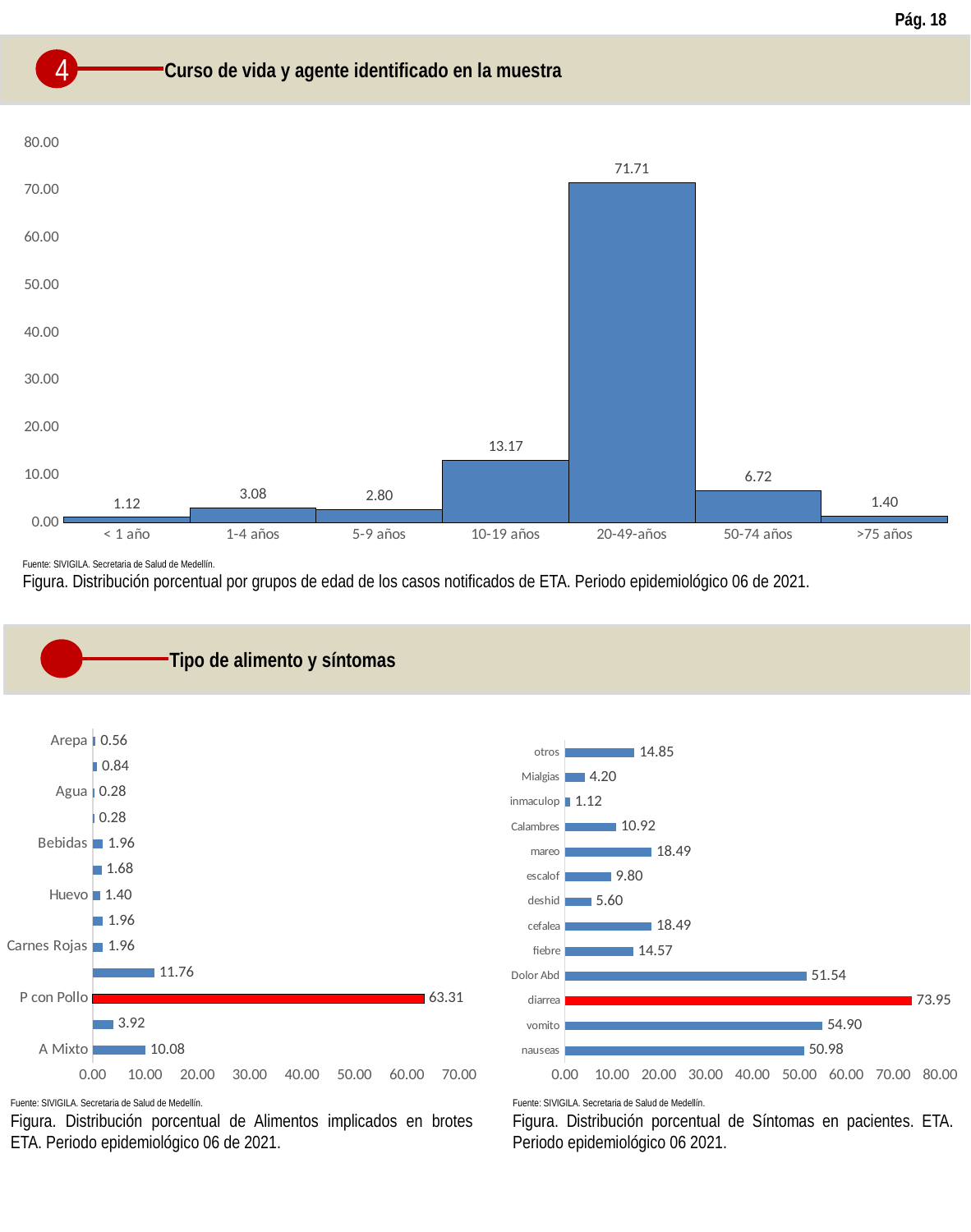
In the bottom-left chart (Alimentos), what is the value for A Mixto? 10.08 What kind of chart is the top chart (age groups)? bar chart In the top chart (age groups), which age group has the highest value? 20-49-años In the top chart (age groups), which age group has the lowest value? < 1 año In the bottom-left chart (Alimentos), what is the value for P con Pollo? 63.31 In the bottom-right chart (Síntomas), which symptom has the highest value? diarrea In the bottom-right chart (Síntomas), which is larger, vomito or nauseas? vomito In the top chart (age groups), what is the difference between the values for 10-19 años and 50-74 años? 6.45 In the top chart (age groups), what is the value for 20-49-años? 71.71 In the bottom-right chart (Síntomas), what is the difference between the values for diarrea and vomito? 19.05 In the bottom-right chart (Síntomas), what is the value for Dolor Abd? 51.54 How many age groups are shown in the top chart? 7